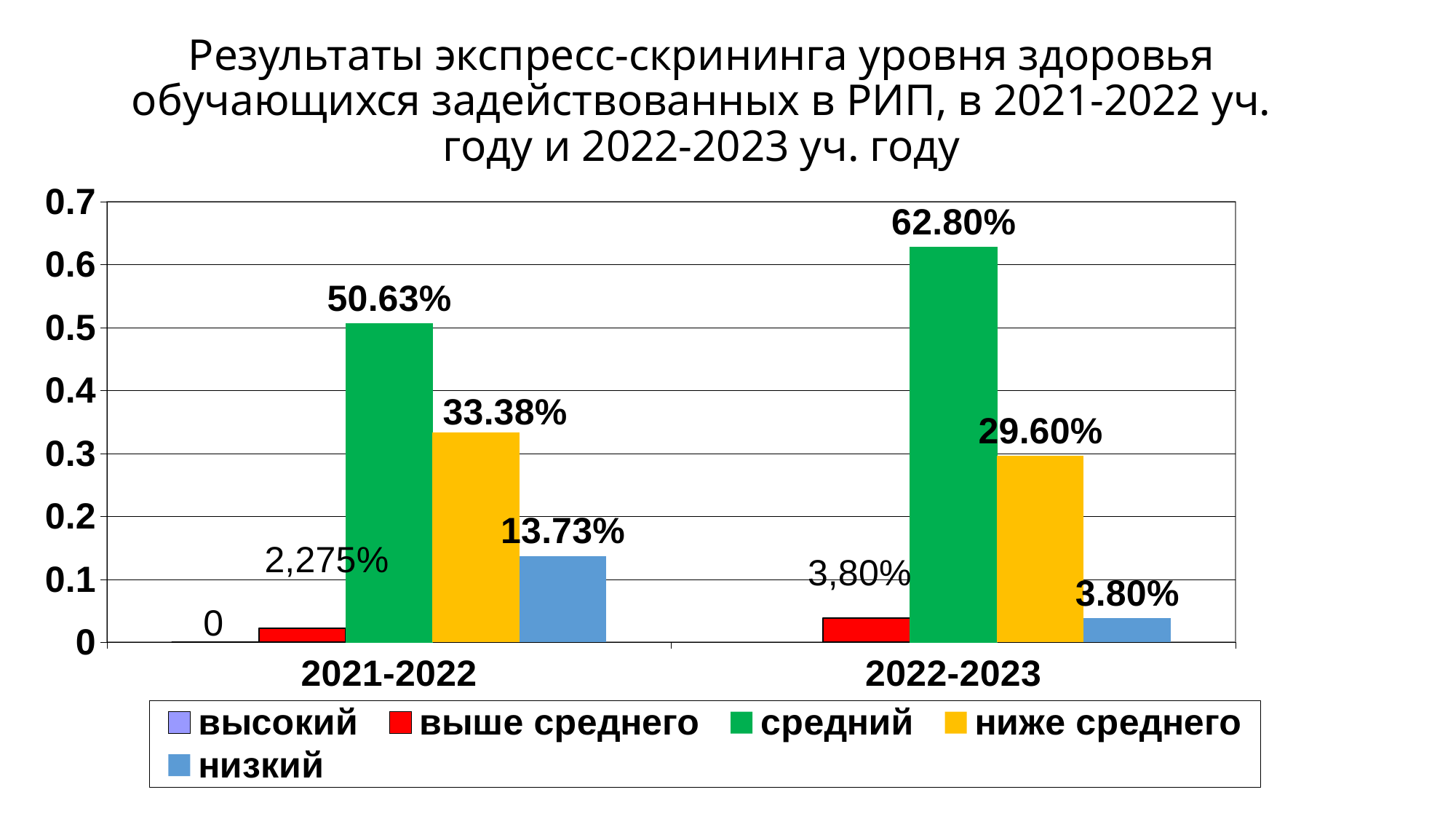
How many series does the legend list? 5 How many categories are shown on the x axis? 2 Which series has the lowest value in 2021-2022? высокий What is the value for низкий in 2022-2023? 3.80% What is the value for ниже среднего in 2021-2022? 33.38% Does the value for средний rise or fall from 2021-2022 to 2022-2023? Rise Which series has the highest value in 2022-2023? средний What type of chart is shown on the slide? Bar chart Which is larger: низкий in 2021-2022 or низкий in 2022-2023? низкий in 2021-2022 What is the value for средний in 2022-2023? 62.80% What is the value for средний in 2021-2022? 50.63% What is the value for выше среднего in 2021-2022? 2,275%